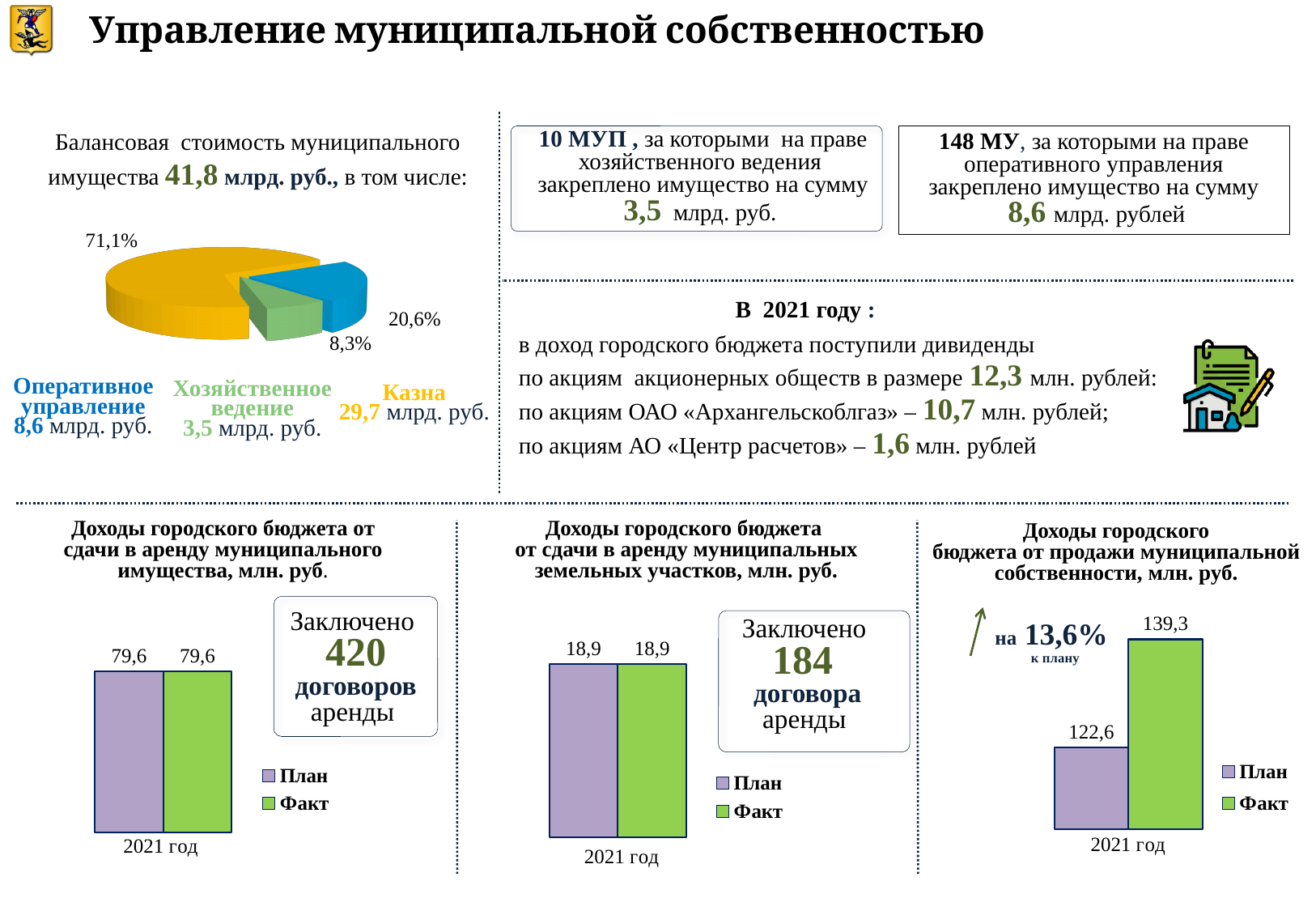
In the chart 'Доходы городского бюджета от продажи муниципальной собственности', what is the difference between Факт and План? 16,7 In the pie chart of the balance value of municipal property, what share does Оперативное управление have? 20,6% What kind of chart is used to show the structure of the balance value of municipal property? pie chart How many series does the legend list in the chart 'Доходы городского бюджета от сдачи в аренду муниципальных земельных участков'? 2 In the pie chart of the balance value of municipal property, how many slices are there? 3 In the pie chart of the balance value of municipal property, what share does Казна have? 71,1% In the chart 'Доходы городского бюджета от сдачи в аренду муниципальных земельных участков', what is the План value for 2021 год? 18,9 In the chart 'Доходы городского бюджета от сдачи в аренду муниципального имущества', what is the Факт value for 2021 год? 79,6 In the chart 'Доходы городского бюджета от продажи муниципальной собственности', which is larger, План or Факт? Факт In the pie chart of the balance value of municipal property, which category has the smallest share? Хозяйственное ведение What kind of chart is 'Доходы городского бюджета от продажи муниципальной собственности'? bar chart In the chart 'Доходы городского бюджета от продажи муниципальной собственности', what is the Факт value for 2021 год? 139,3